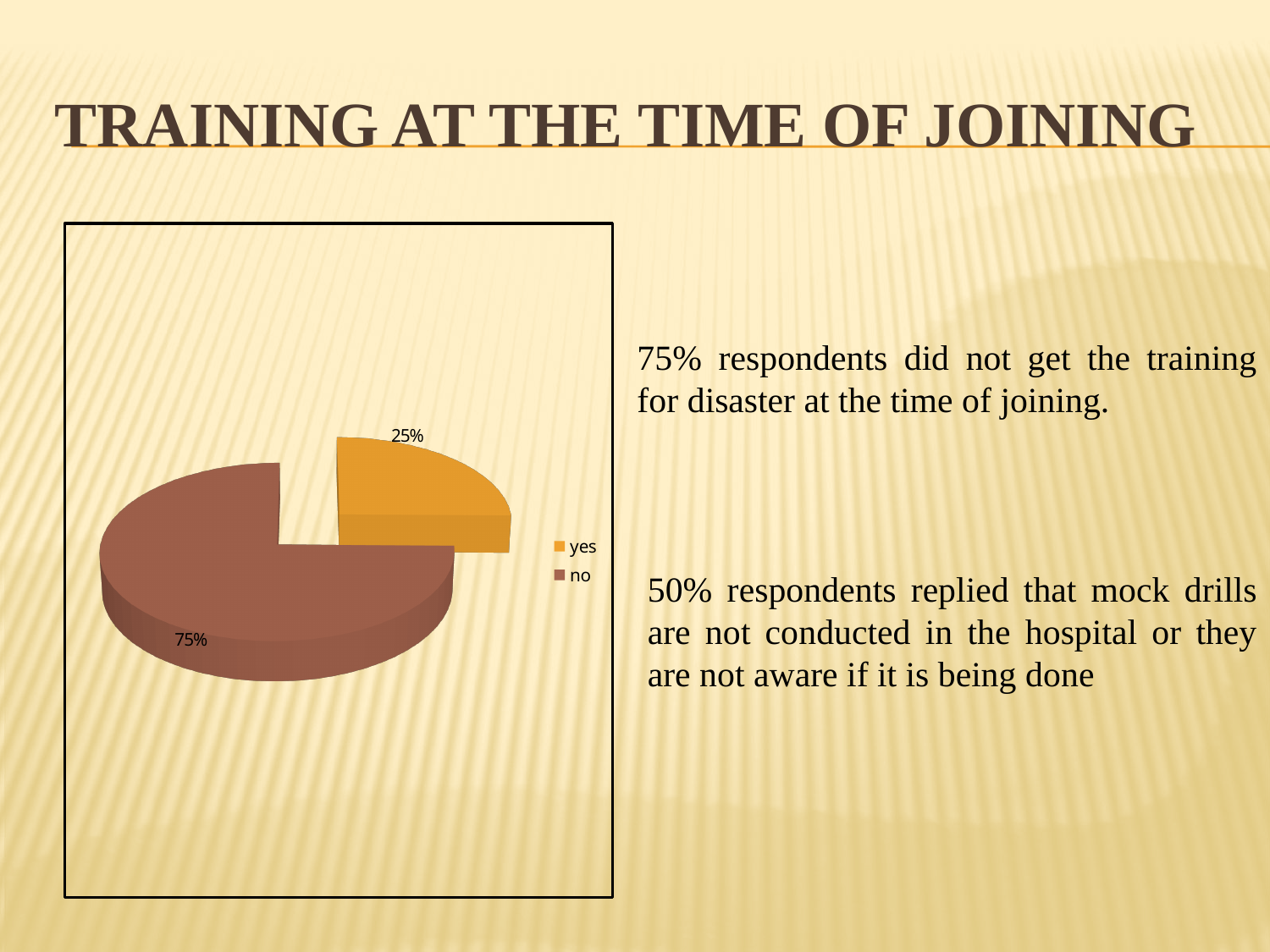
Which slice is larger, "yes" or "no"? no What kind of chart is shown on the slide? pie chart Which category has the smallest share of the pie? yes What colour is the "yes" slice in the pie chart? orange How many entries does the legend list? 2 What percentage of the pie is labelled "yes"? 25% What is the difference in percentage points between the "no" and "yes" slices? 50 How many slices does the pie chart have? 2 What percentage of the pie is labelled "no"? 75% Which category has the largest share of the pie? no What share of the pie does the "no" slice represent? 75% What is the title of the slide containing the pie chart? TRAINING AT THE TIME OF JOINING